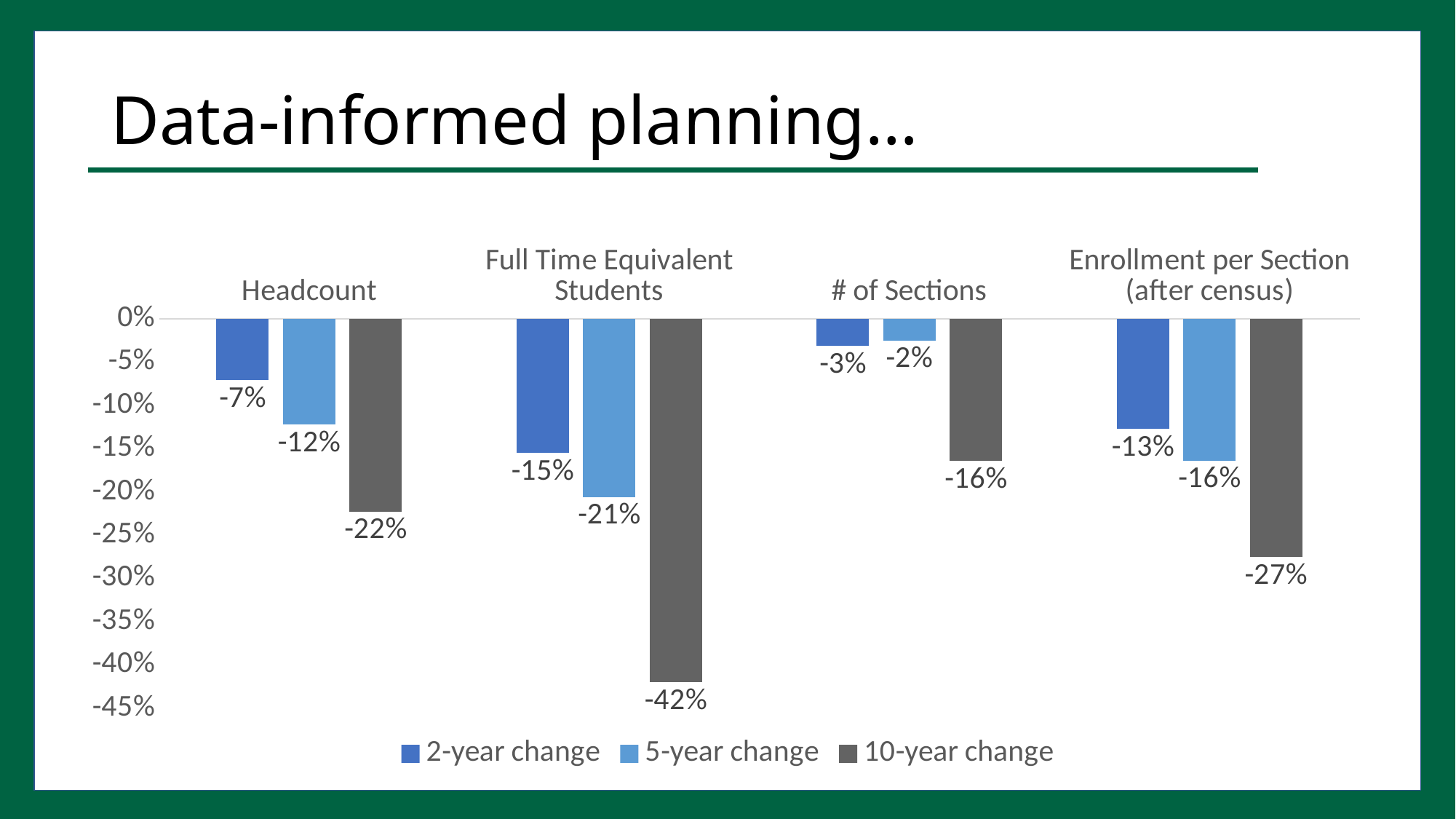
How many series does the legend list? 3 Which series is shown in dark grey in the legend? 10-year change What is the 10-year change for Full Time Equivalent Students? -42% How many categories are shown on the x axis? 4 Which is larger in magnitude: the 5-year change for Headcount or the 5-year change for Enrollment per Section (after census)? Enrollment per Section (after census) What kind of chart is shown on the slide? Bar chart What is the 2-year change for Headcount? -7% Which category has the highest (least negative) 2-year change value? # of Sections What is the difference between the 10-year change and the 2-year change for Headcount? 15 percentage points What is the 5-year change for # of Sections? -2% Which category has the lowest 10-year change value? Full Time Equivalent Students What is the 10-year change for Enrollment per Section (after census)? -27%